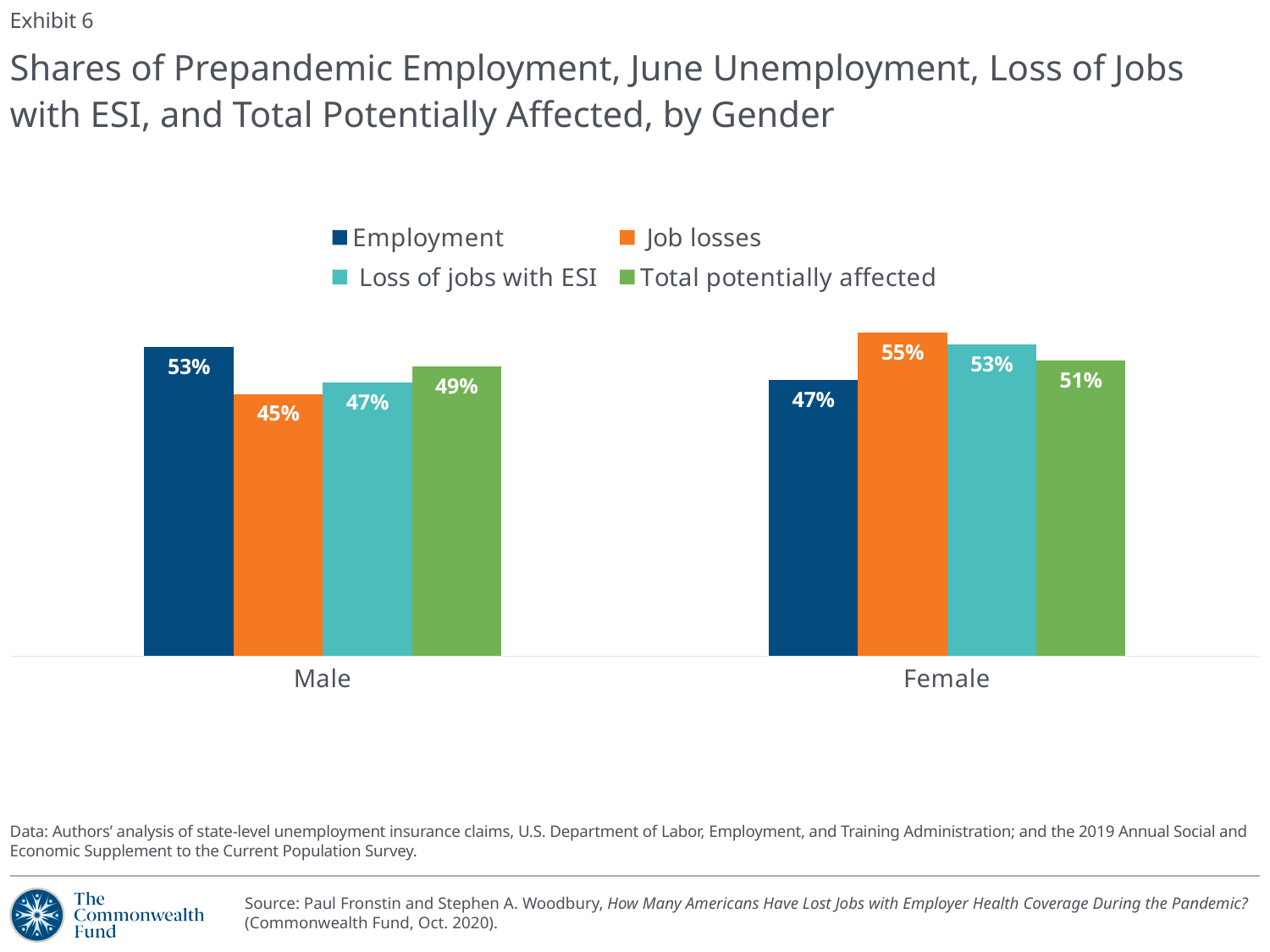
What is the Employment share for Male? 53% What is the Loss of jobs with ESI share for Male? 47% Which is larger, the Employment share for Male or for Female? Male What kind of chart is shown on the slide? Bar chart How many categories are shown on the x axis? 2 How many series does the legend list? 4 What colour represents the Job losses series? Orange What is the difference between the Job losses share for Female and for Male? 10% Which series has the highest value for Female? Job losses What is the Job losses share for Female? 55% What is the Total potentially affected share for Female? 51% Which series has the lowest value for Male? Job losses